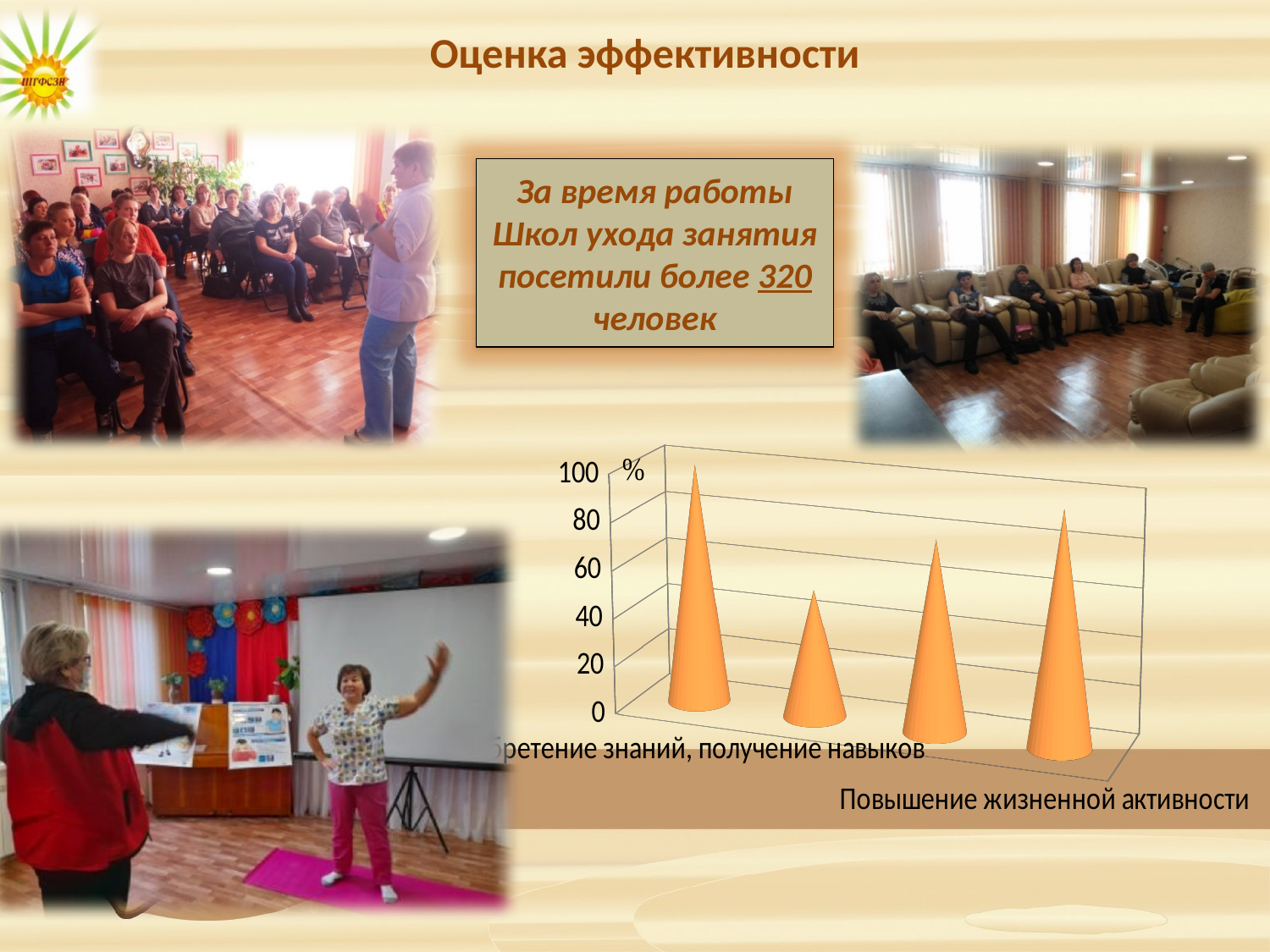
Which bar in the chart is the shortest? the second bar from the left What kind of chart is shown on the slide? bar chart Which is larger: the leftmost bar or the second bar from the left? the leftmost bar Which is larger: the rightmost bar or the second bar from the left? the rightmost bar Which bar in the chart is the tallest? the leftmost (first) bar How many bars (cones) are plotted in the chart? 4 What is the highest value shown on the vertical axis of the chart? 100 Is the value of the third bar from the left greater or less than 40? greater Is the value of the leftmost bar greater or less than 80? greater Is the value of the second bar from the left greater or less than 80? less What unit is shown on the vertical axis of the chart? %